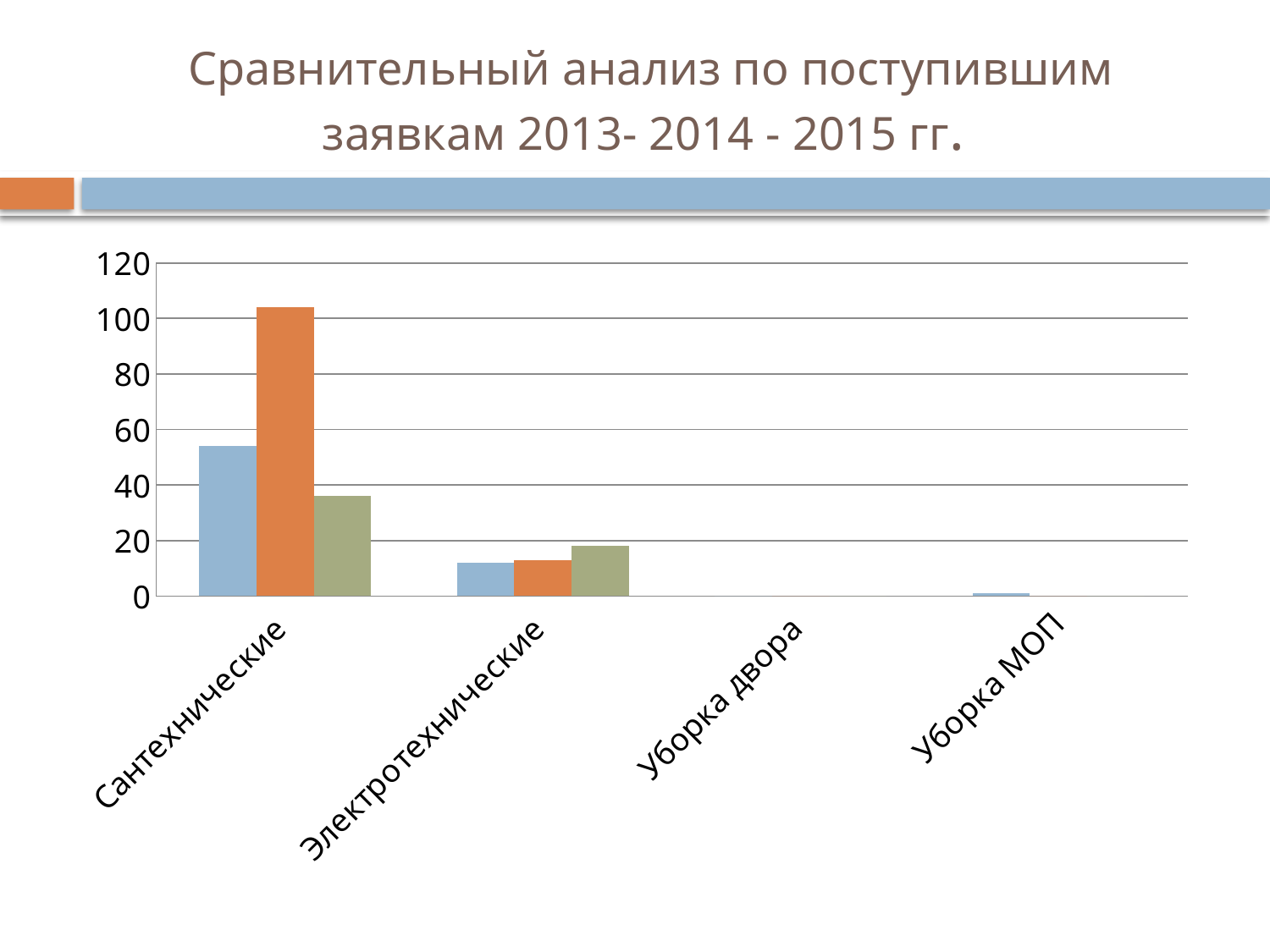
Which category has the tallest bar in the chart? Сантехнические How many categories are shown on the x axis of the chart? 4 Is the value of the green bar for Сантехнические greater or less than 20? greater Is the value of the blue bar for Сантехнические greater or less than 60? less Which is larger for Сантехнические: the orange bar or the blue bar? the orange bar Which is larger for Электротехнические: the green bar or the blue bar? the green bar What is the highest value shown on the y axis of the chart? 120 What is the title of the slide containing the chart? Сравнительный анализ по поступившим заявкам 2013- 2014 - 2015 гг. Is the value of the orange bar for Сантехнические greater or less than 100? greater Which category has the lowest values in the chart? уборка двора What kind of chart is shown on the slide? bar chart